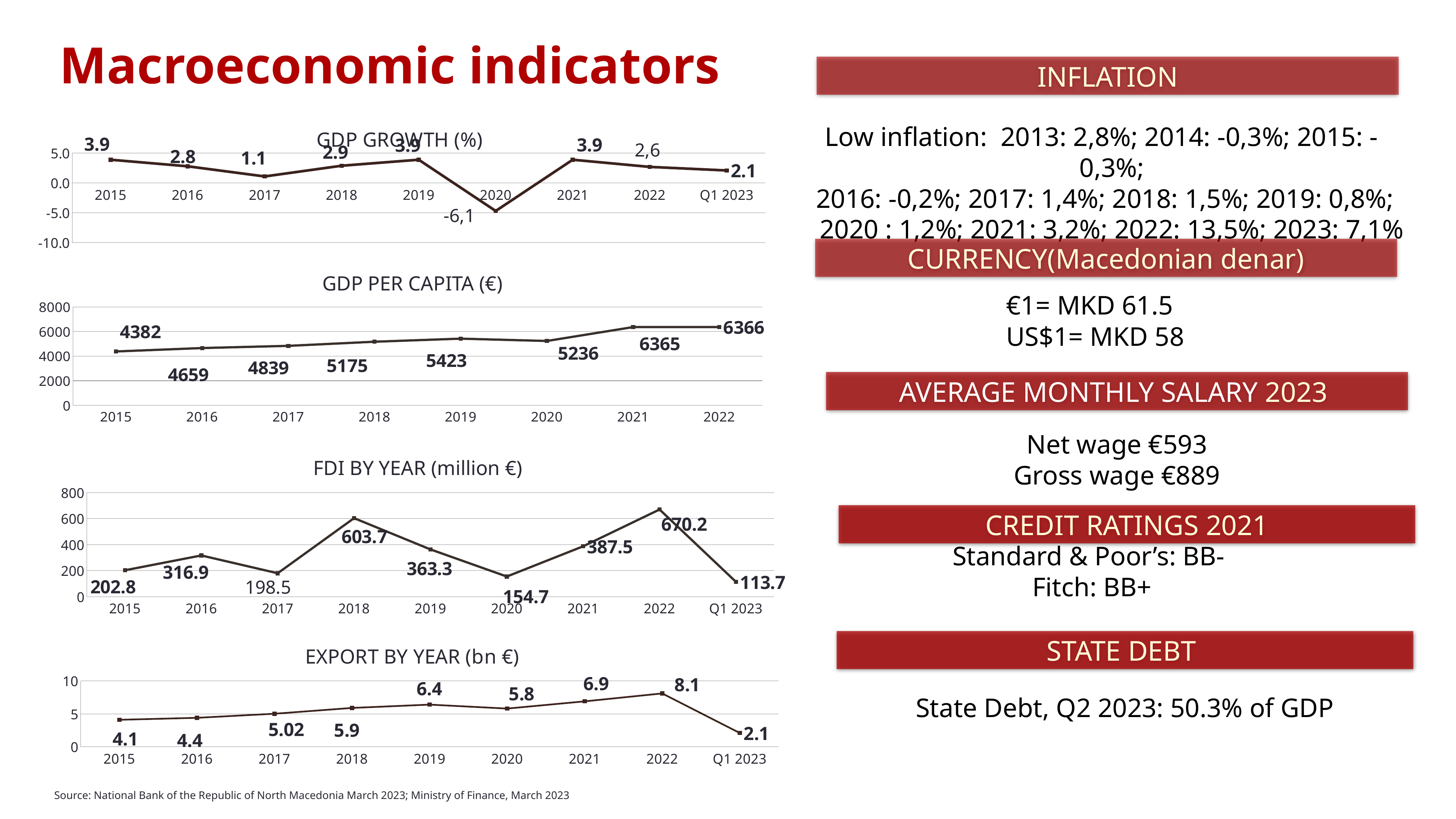
In the GDP PER CAPITA (€) chart, what is the value for 2018? 5175 In the FDI BY YEAR (million €) chart, which is larger, the value for 2016 or the value for 2017? 2016 In the EXPORT BY YEAR (bn €) chart, which period has the lowest value? Q1 2023 In the GDP PER CAPITA (€) chart, how many years are plotted? 8 In the EXPORT BY YEAR (bn €) chart, what is the value for 2017? 5.02 In the FDI BY YEAR (million €) chart, what is the value for 2018? 603.7 In the FDI BY YEAR (million €) chart, what is the difference between the 2022 and 2021 values? 282.7 In the GDP PER CAPITA (€) chart, which year has the lowest value? 2015 What type of chart is the EXPORT BY YEAR (bn €) chart? Line chart In the FDI BY YEAR (million €) chart, which year has the highest value? 2022 In the GDP GROWTH (%) chart, what is the value for 2020? -6,1 In the GDP GROWTH (%) chart, which year has the lowest value? 2020